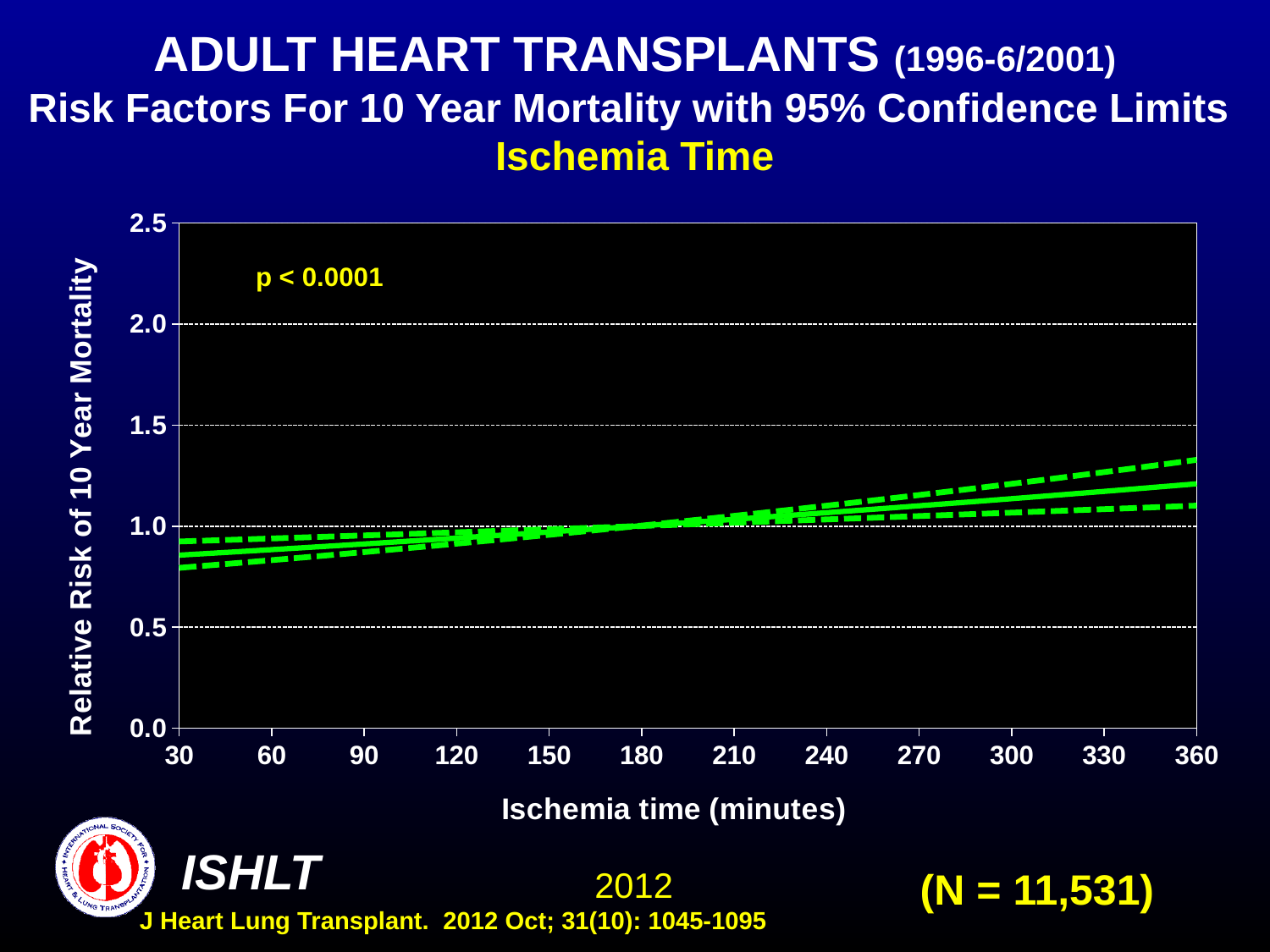
What p-value is printed on the chart? p < 0.0001 Is the upper 95% confidence limit at an ischemia time of 360 minutes greater or less than 1.5? less Does the relative risk of 10 year mortality rise or fall as ischemia time increases from 30 to 360 minutes? rise Is the upper 95% confidence limit at an ischemia time of 30 minutes greater or less than 1.0? less Is the relative risk (solid line) at an ischemia time of 30 minutes greater or less than 1.0? less What kind of chart is shown on the slide? line chart How many tick marks are labelled on the x axis (ischemia time)? 12 What is the highest value labelled on the y axis? 2.5